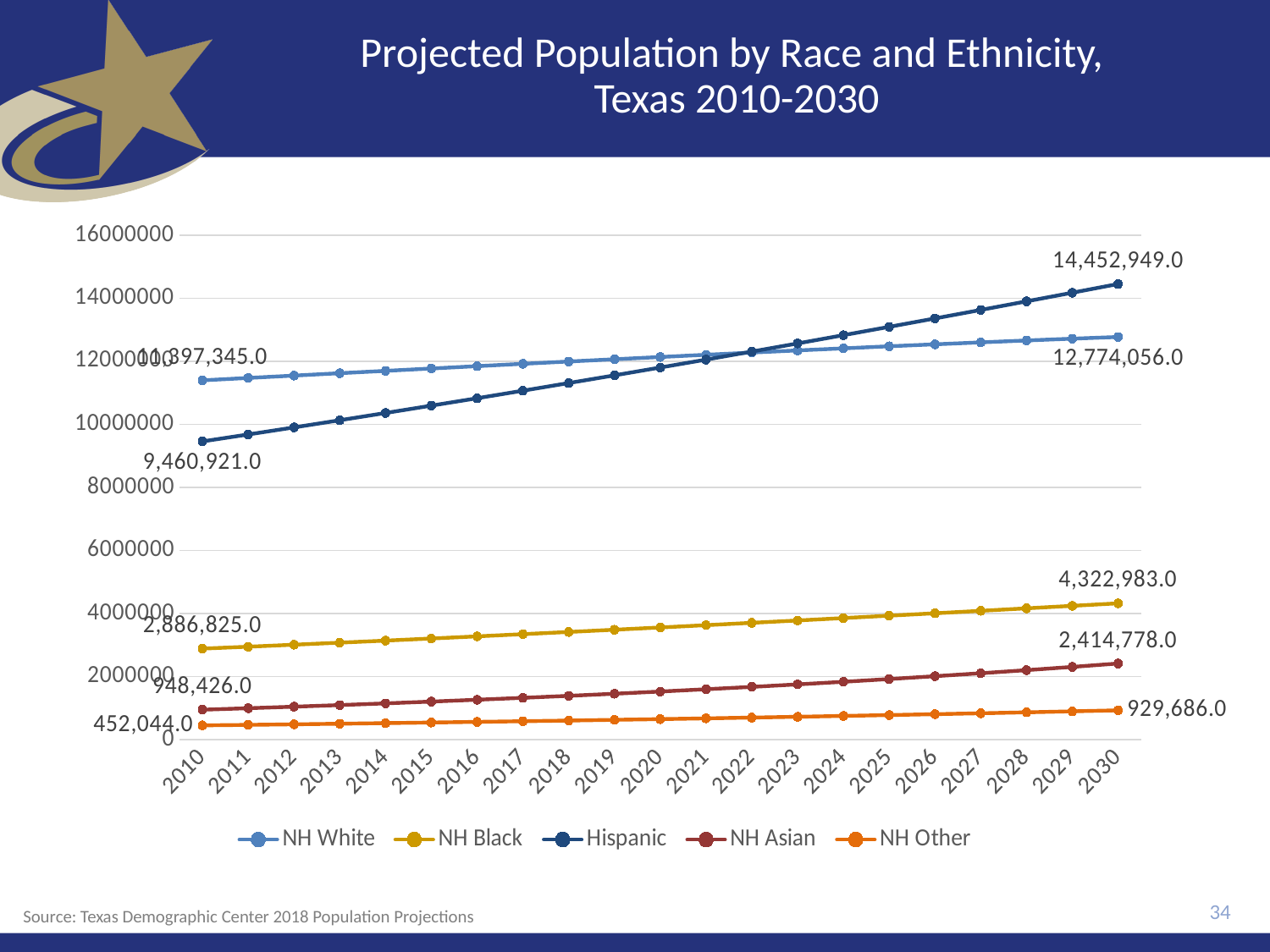
By how much does the Hispanic population increase from 2010 to 2030? 4,992,028.0 Is the NH White value for 2020 greater or less than 10000000? greater How many series does the legend list? 5 What is the NH Other population value shown for 2010? 452,044.0 What is the projected NH Asian population in 2030? 2,414,778.0 Which series has the lowest value in 2030? NH Other What kind of chart is shown on the slide? line chart Which series has the highest value in 2030? Hispanic What is the Hispanic population value shown for 2010? 9,460,921.0 What is the projected NH Black population in 2030? 4,322,983.0 What is the projected Hispanic population in 2030? 14,452,949.0 How many years are plotted along the x axis? 21